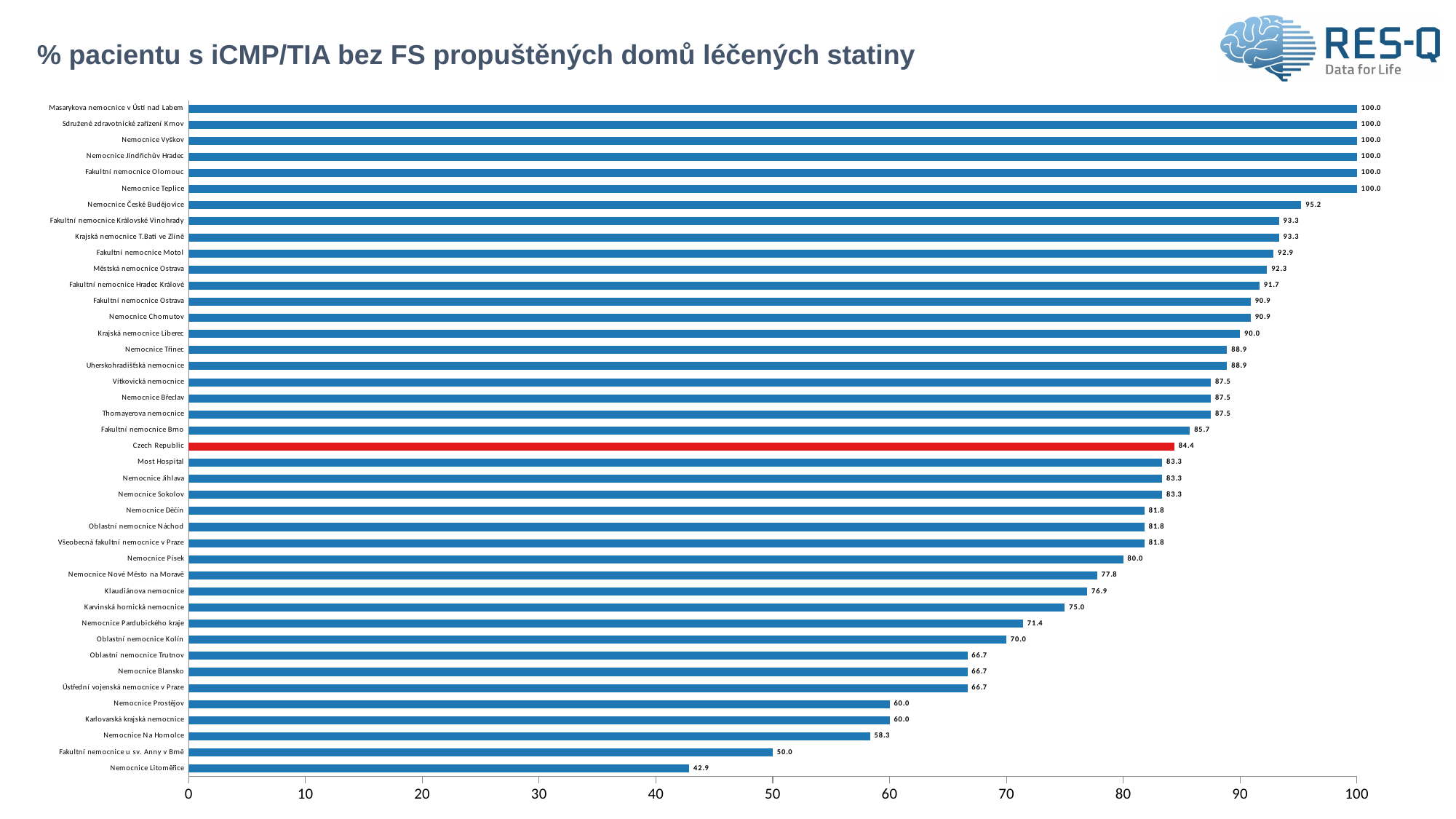
What is the value for Oblastní nemocnice Kolín? 70.0 What is the value for Czech Republic? 84.4 How many bars are shown in the chart? 42 Is the value for Nemocnice Pardubického kraje greater or less than 80? less Which hospital has the lowest value? Nemocnice Litoměřice What kind of chart is shown on the slide? bar chart What is the value for Nemocnice České Budějovice? 95.2 What is the difference between the values for Nemocnice Litoměřice and Fakultní nemocnice u sv. Anny v Brně? 7.1 Which is larger, the value for Nemocnice Písek or the value for Karvinská hornická nemocnice? Nemocnice Písek Which bar is highlighted in red? Czech Republic What is the value for Nemocnice Na Homolce? 58.3 What is the difference between the values for Fakultní nemocnice Brno and Czech Republic? 1.3